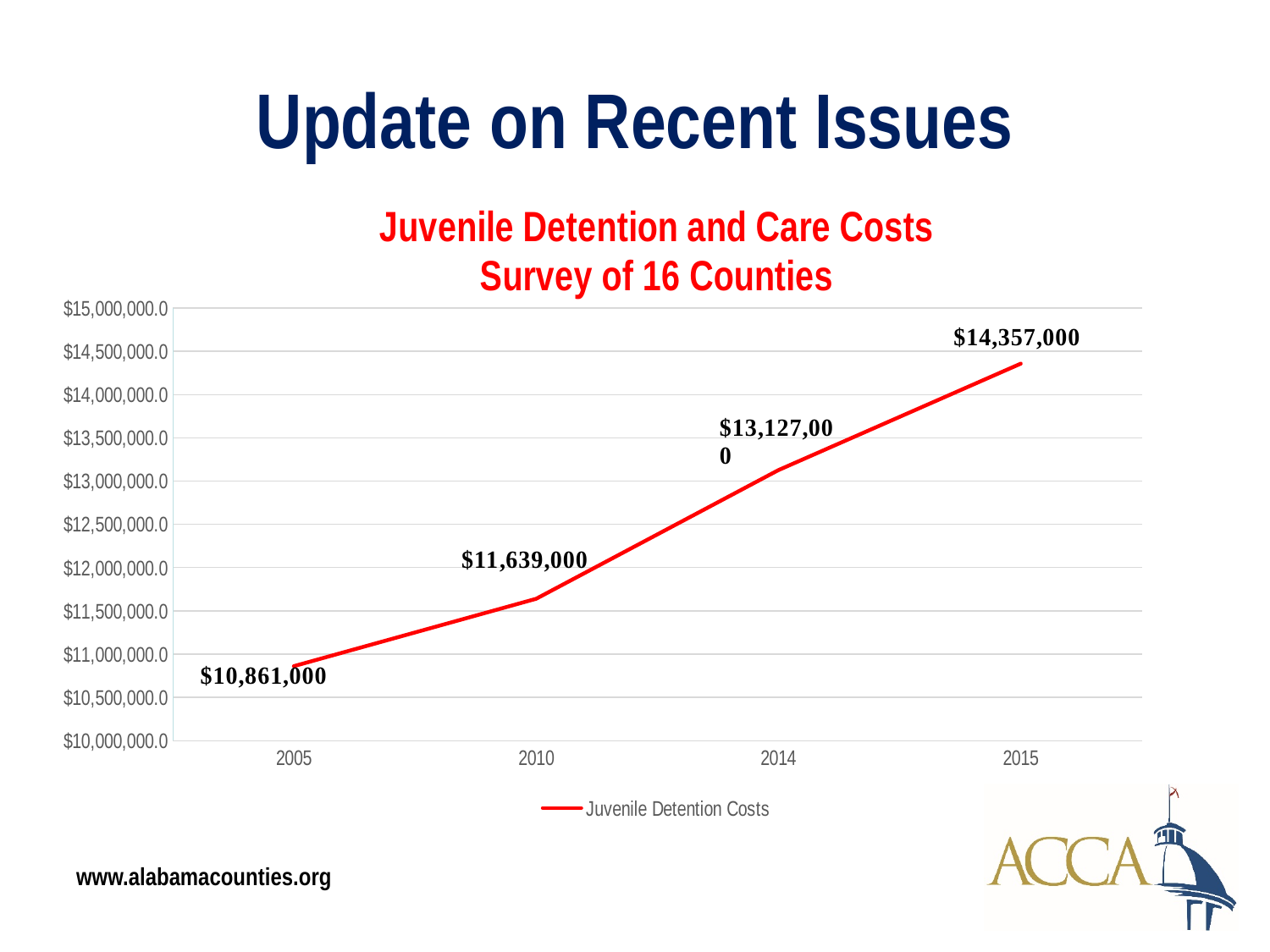
What is the value for Juvenile Detention Costs in 2005? $10,861,000 What is the value for Juvenile Detention Costs in 2010? $11,639,000 Do the Juvenile Detention Costs rise or fall from 2005 to 2015? Rise What is the value for Juvenile Detention Costs in 2015? $14,357,000 What is the value for Juvenile Detention Costs in 2014? $13,127,000 Which year has the highest Juvenile Detention Costs? 2015 What kind of chart is shown on the slide? Line chart What is the difference between the Juvenile Detention Costs in 2014 and 2010? $1,488,000 What is the difference between the Juvenile Detention Costs in 2015 and 2005? $3,496,000 How many years are plotted on the chart? 4 Which is larger, the Juvenile Detention Costs in 2010 or in 2014? 2014 Which year has the lowest Juvenile Detention Costs? 2005